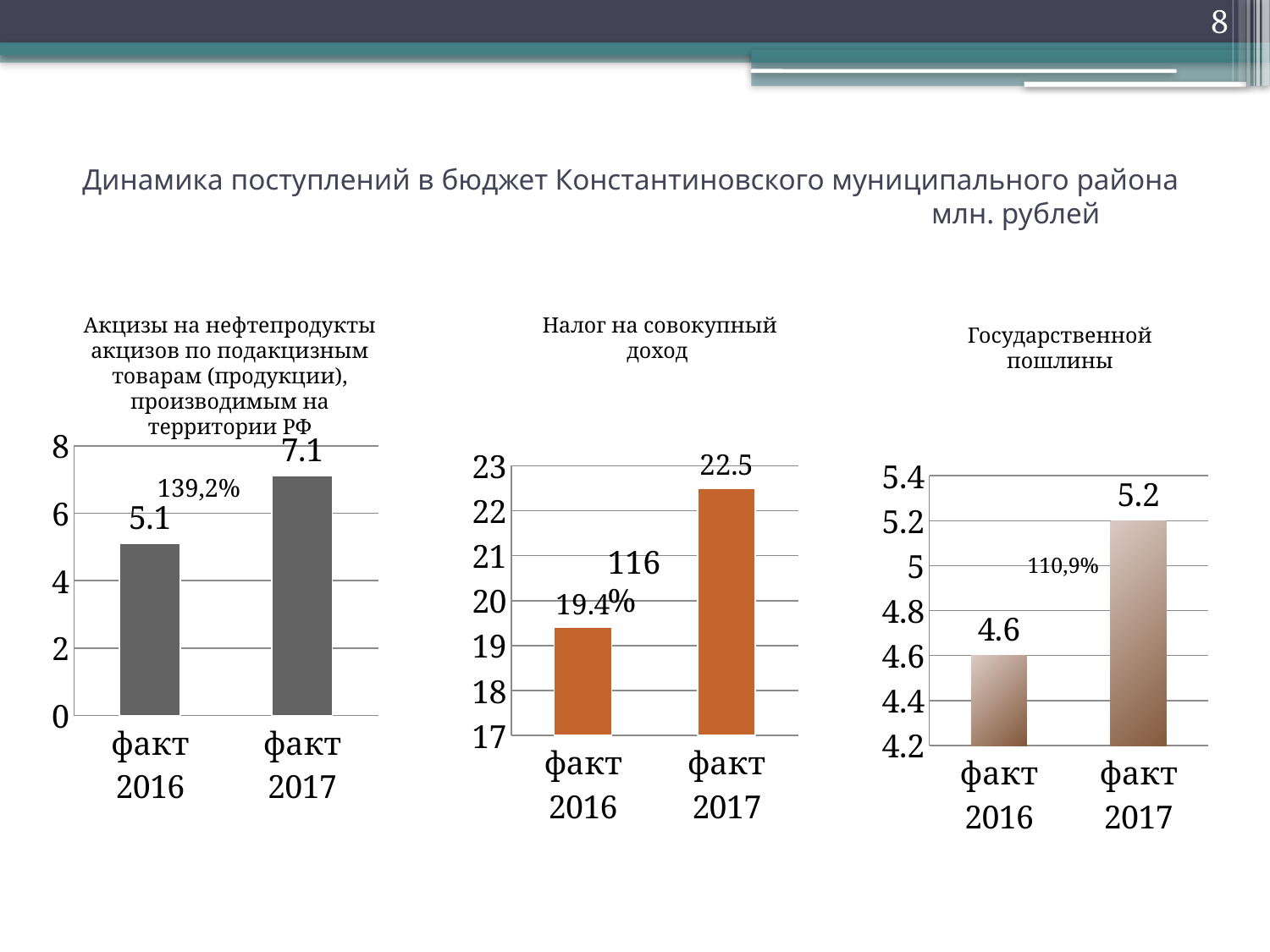
In the chart titled "Налог на совокупный доход", what is the value for факт 2017? 22.5 In the chart titled "Налог на совокупный доход", what is the value for факт 2016? 19.4 In the chart titled "Налог на совокупный доход", what is the difference between факт 2017 and факт 2016? 3.1 In the leftmost chart (Акцизы на нефтепродукты), which category has the higher value? факт 2017 In the leftmost chart (Акцизы на нефтепродукты), what is the value for факт 2017? 7.1 In the leftmost chart (Акцизы на нефтепродукты), what is the difference between факт 2017 and факт 2016? 2 In the leftmost chart (Акцизы на нефтепродукты), what is the value for факт 2016? 5.1 In the chart titled "Государственной пошлины", what is the value for факт 2017? 5.2 What kind of chart is the chart titled "Государственной пошлины"? bar chart How many charts are shown on the slide? 3 In the chart titled "Государственной пошлины", what is the value for факт 2016? 4.6 In the chart titled "Государственной пошлины", what is the difference between факт 2017 and факт 2016? 0.6